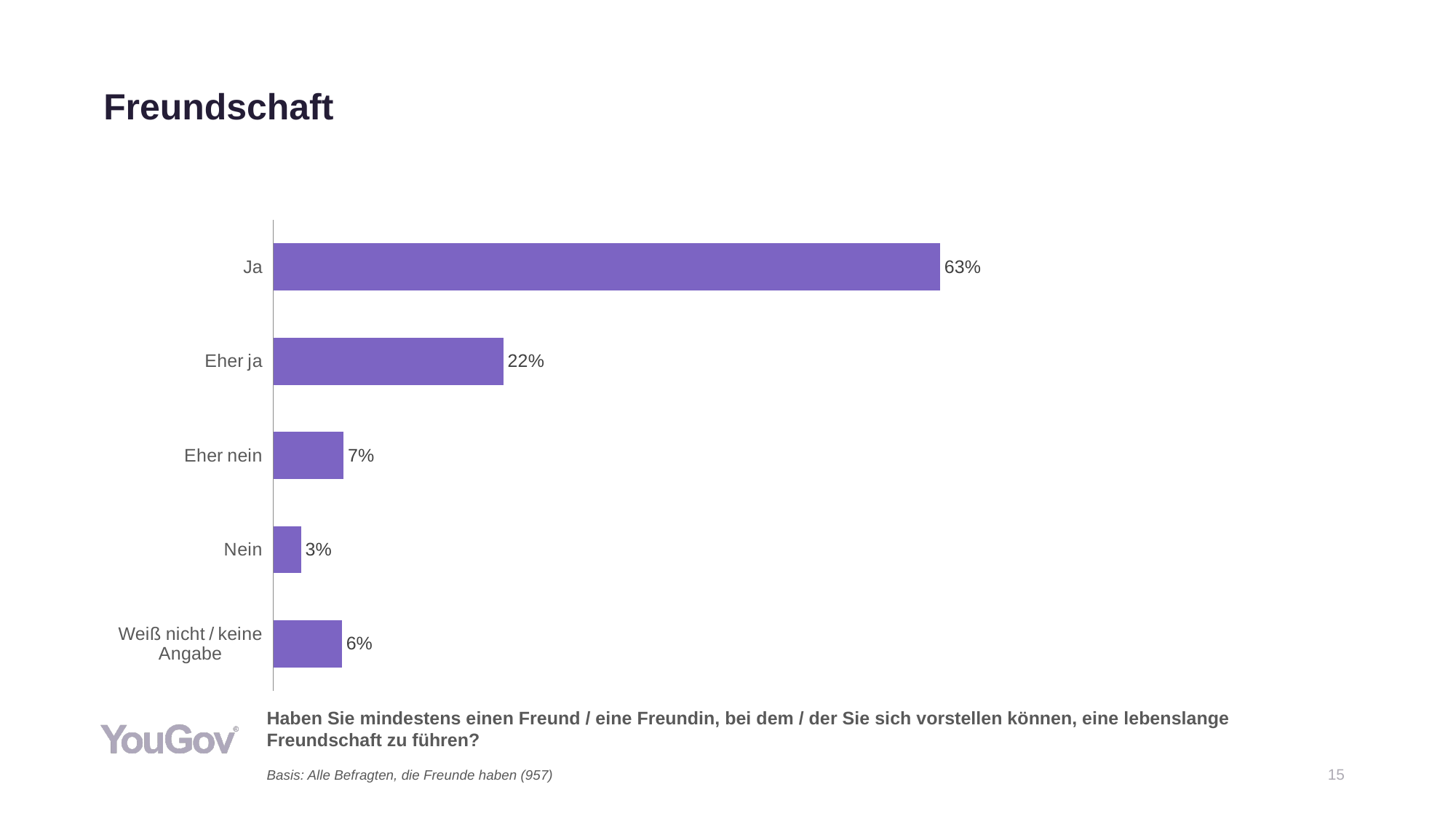
What is the title of the slide? Freundschaft Which category has the highest value? Ja What percentage of respondents answered "Ja"? 63% Which is larger, the value for "Eher nein" or the value for "Weiß nicht / keine Angabe"? Eher nein What is the value for "Weiß nicht / keine Angabe"? 6% What is the difference between the values for "Eher nein" and "Nein"? 4% Which category has the lowest value? Nein How many categories are shown in the chart? 5 What kind of chart is shown on the slide? Bar chart What is the value shown for "Eher ja"? 22% What percentage is shown for "Eher nein"? 7% What is the difference between the values for "Ja" and "Eher ja"? 41%